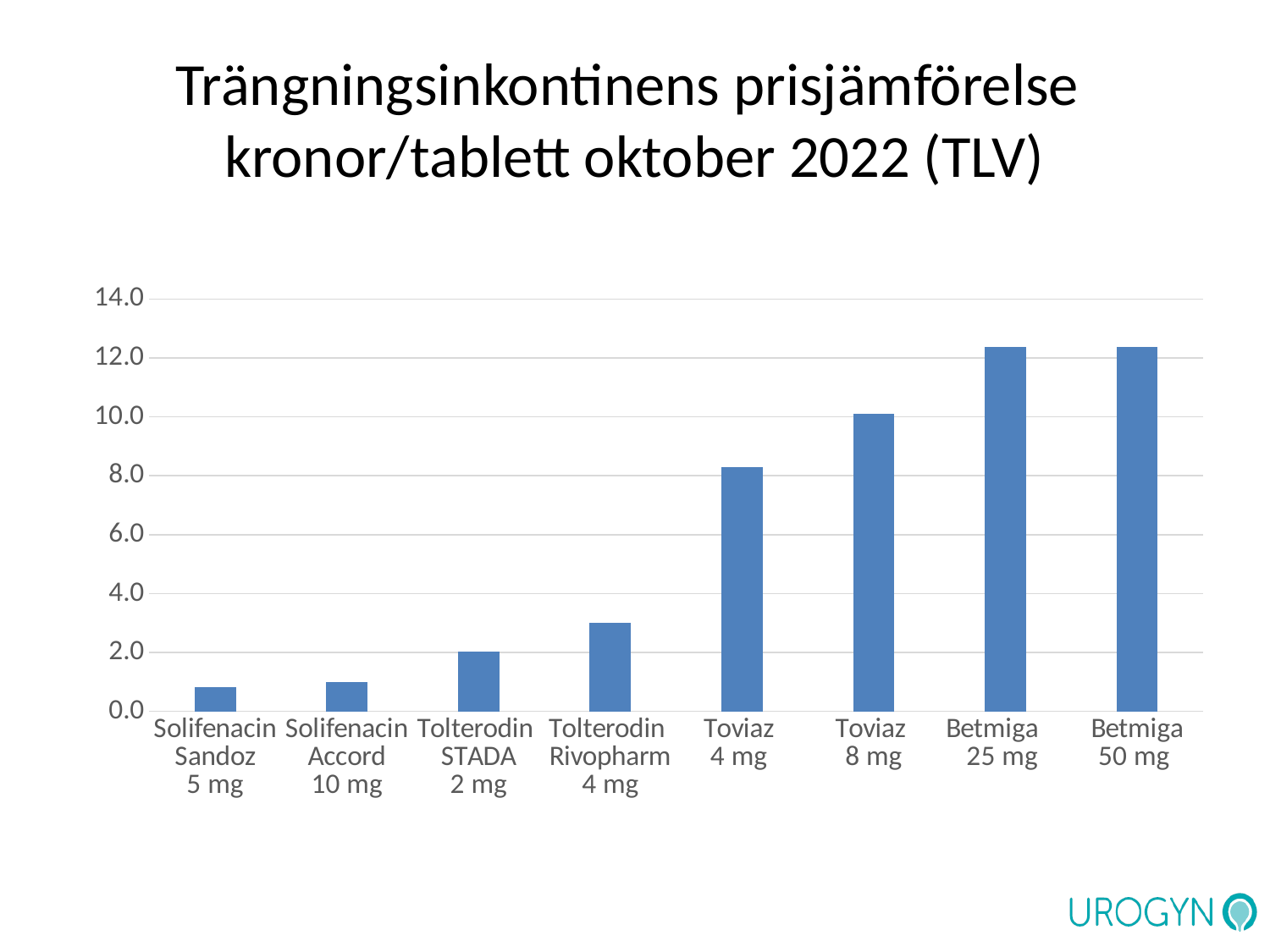
Is the value for Solifenacin Sandoz 5 mg greater or less than 2.0? less How many products (categories) are shown on the x axis of the chart? 8 Which has the larger value, Tolterodin Rivopharm 4 mg or Solifenacin Accord 10 mg? Tolterodin Rivopharm 4 mg Is the value for Tolterodin Rivopharm 4 mg greater or less than 2.0? greater Which has the larger value, Toviaz 4 mg or Toviaz 8 mg? Toviaz 8 mg Is the value for Toviaz 4 mg greater or less than 10.0? less Which has the larger value, Betmiga 25 mg or Toviaz 8 mg? Betmiga 25 mg Do the bar values generally rise or fall from left to right along the x axis? rise What kind of chart is shown on the slide? bar chart What is the title of the chart on the slide? Trängningsinkontinens prisjämförelse kronor/tablett oktober 2022 (TLV)